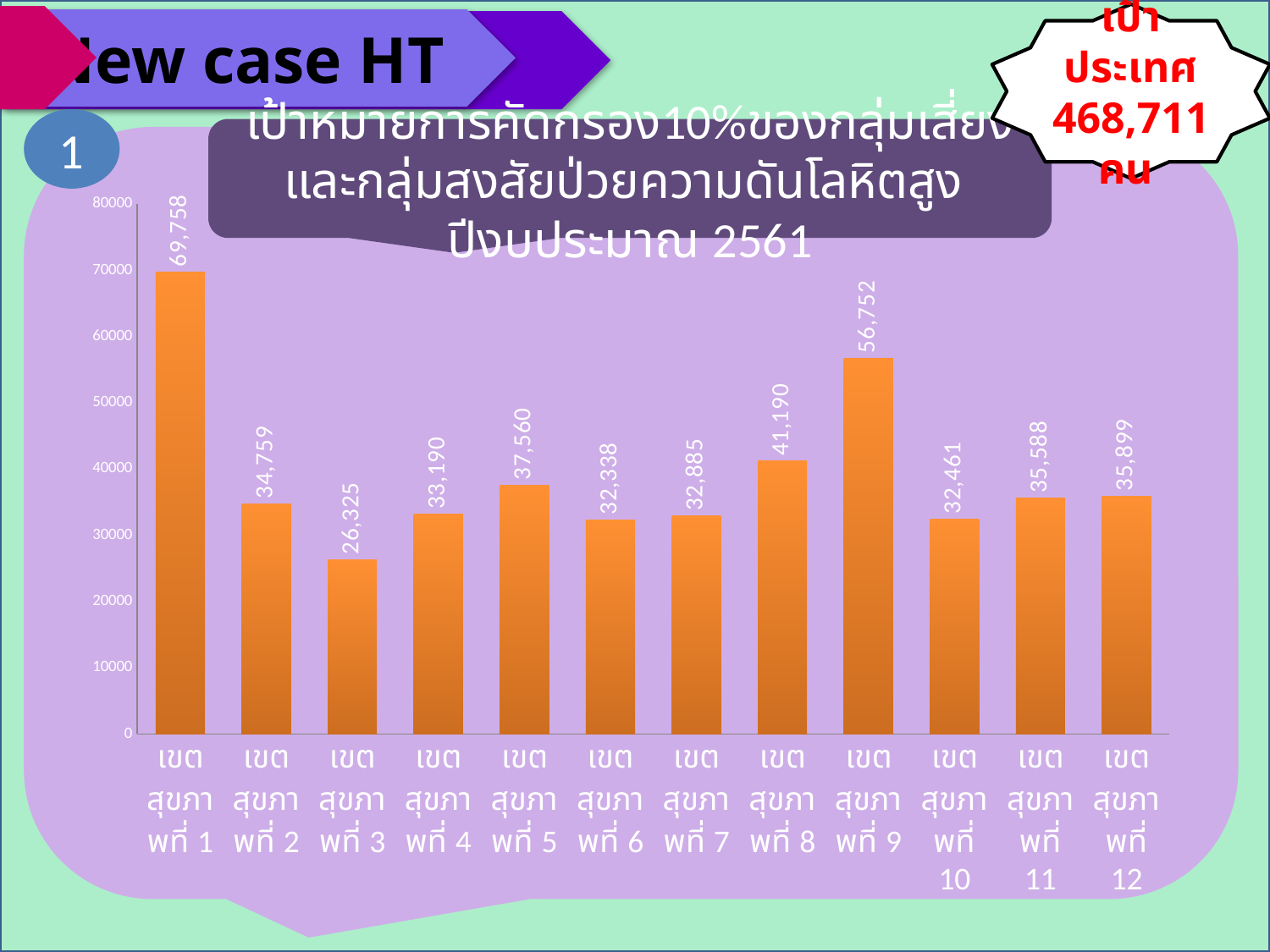
What kind of chart is shown on the slide? bar chart What is the value for เขตสุขภาพที่ 12? 35,899 What is the value for เขตสุขภาพที่ 8? 41,190 Which health region has the lowest value? เขตสุขภาพที่ 3 How many health regions are shown on the x axis? 12 What is the difference between the values for เขตสุขภาพที่ 1 and เขตสุขภาพที่ 9? 13,006 Is the value for เขตสุขภาพที่ 8 greater or less than 40000? greater What is the value for เขตสุขภาพที่ 1? 69,758 Which is larger, the value for เขตสุขภาพที่ 2 or เขตสุขภาพที่ 11? เขตสุขภาพที่ 11 Which health region has the highest value? เขตสุขภาพที่ 1 What is the difference between the values for เขตสุขภาพที่ 5 and เขตสุขภาพที่ 3? 11,235 What is the value for เขตสุขภาพที่ 9? 56,752